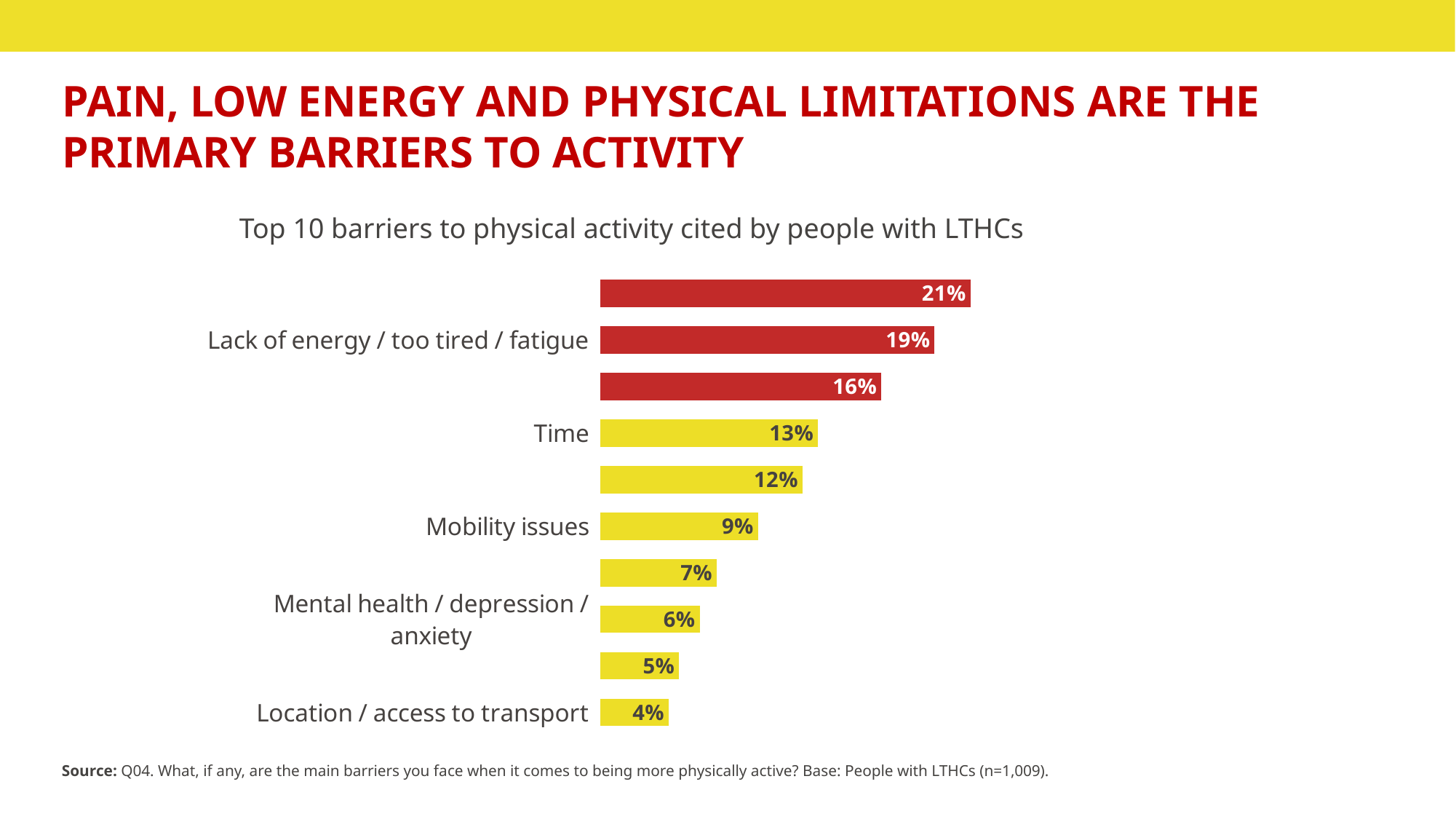
What is the largest value shown on the chart? 21% Which has a higher value, Time or Mobility issues? Time How many bars on the chart are coloured red? 3 How many bars are shown on the chart? 10 What is the difference in percentage points between Lack of energy / too tired / fatigue and Time? 6 What is the value shown for Mental health / depression / anxiety? 6% What is the value shown for Mobility issues? 9% Which labelled barrier has the lowest value on the chart? Location / access to transport What kind of chart is shown on the slide? Bar chart What percentage of people with LTHCs cited lack of energy / too tired / fatigue as a barrier? 19% What is the value shown for Time? 13% What is the value shown for Location / access to transport? 4%